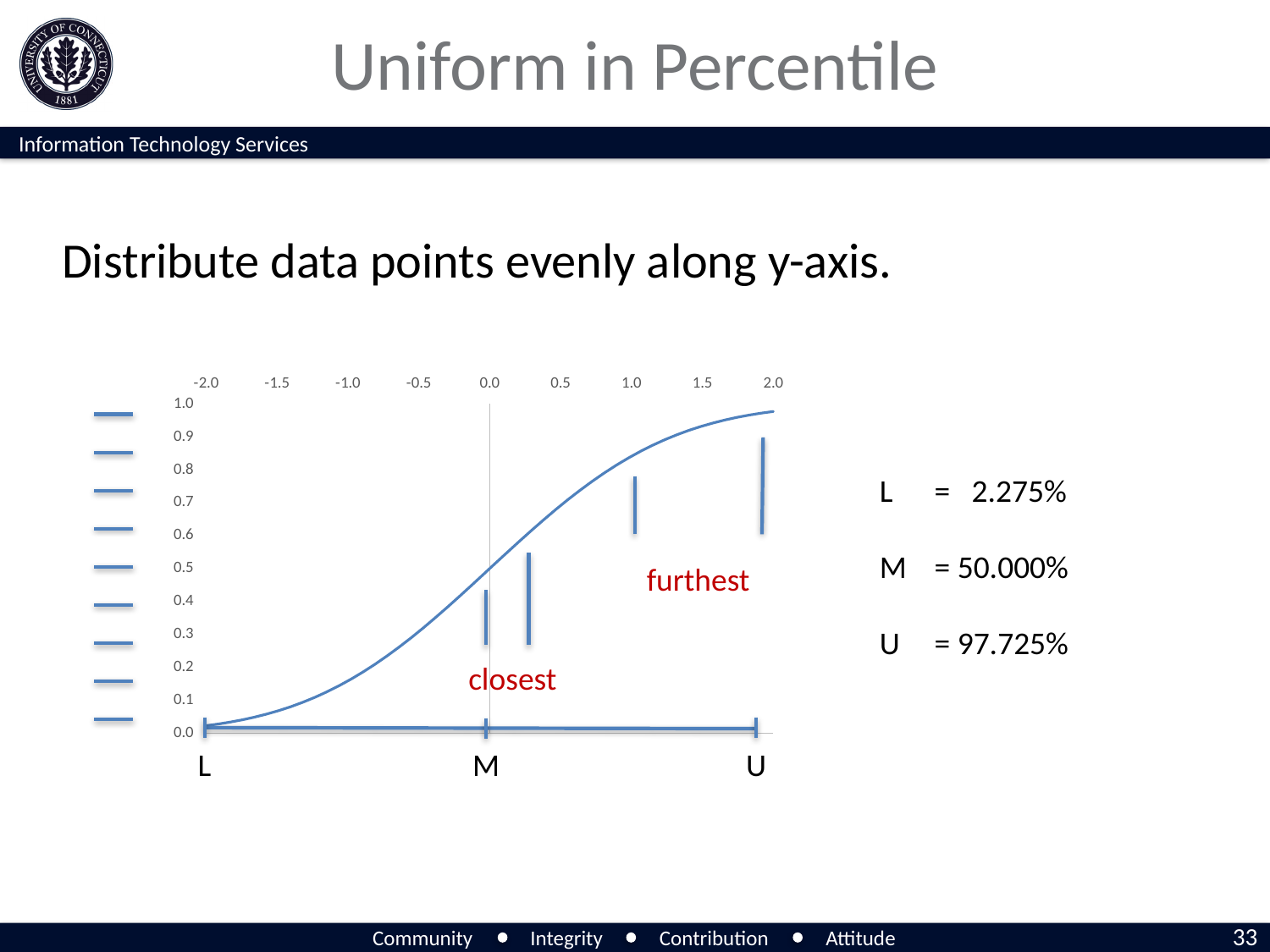
Is the value of the curve at x = 2.0 greater or less than 0.9? greater Which three letters label the points along the bottom of the chart? L, M, U What is the lowest tick value shown on the x axis? -2.0 Is the value of the curve at x = 1.0 greater or less than 0.7? greater What is the highest tick value shown on the y axis? 1.0 Does the plotted curve rise or fall as x increases from -2.0 to 2.0? rise What kind of chart is shown on the slide? line chart How many tick labels are shown along the x axis? 9 Is the value of the curve at x = -1.0 greater or less than 0.3? less What percentile value is given for L on the slide? 2.275% What percentile value is given for U on the slide? 97.725%